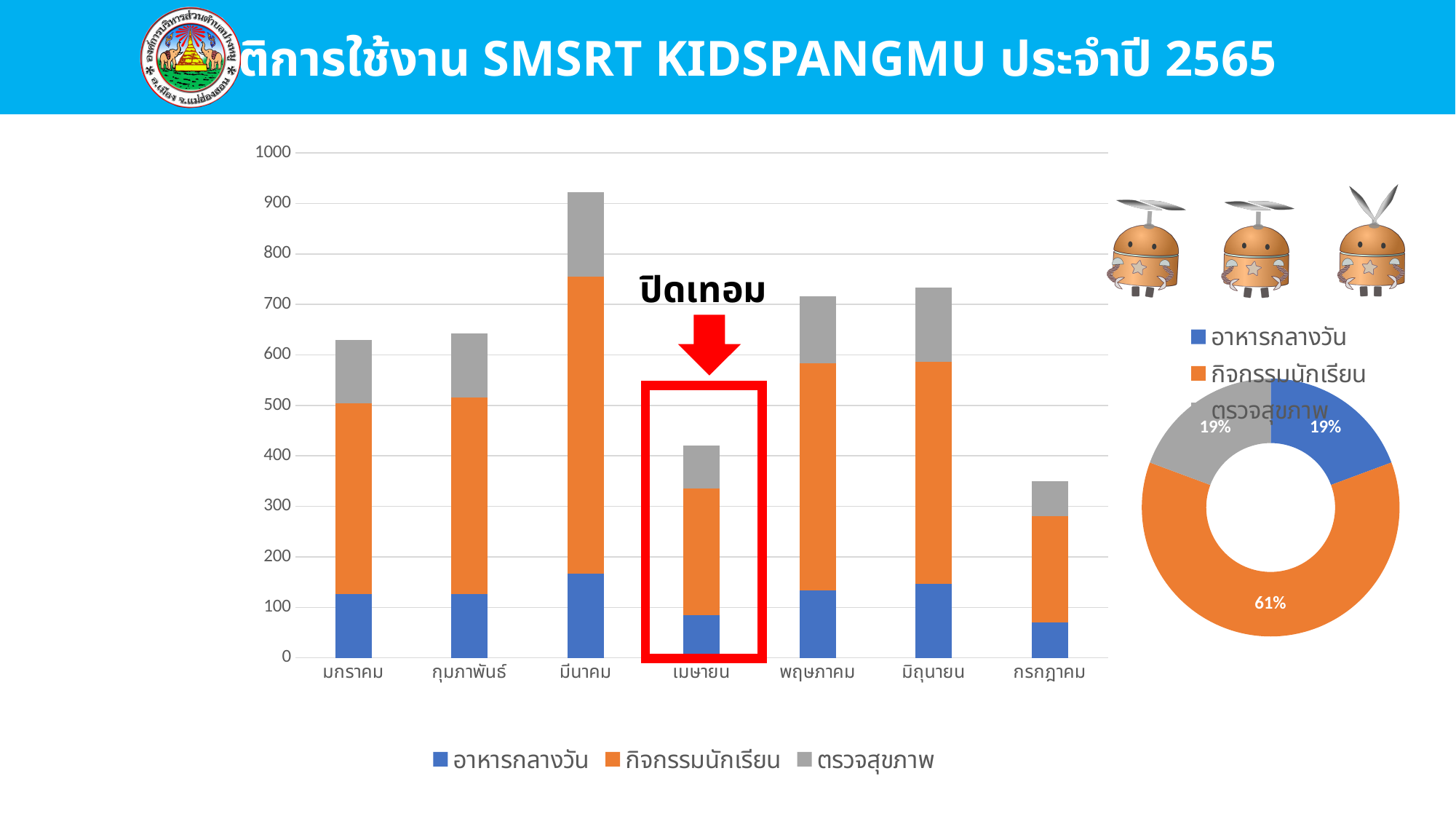
In the bar chart, is the total for มกราคม greater or less than 600? greater In the bar chart, how many months are shown on the x axis? 7 In the bar chart, which month has the larger total bar, มิถุนายน or กุมภาพันธ์? มิถุนายน In the bar chart, which month has the lowest total bar? กรกฎาคม In the donut chart on the right, what share does อาหารกลางวัน have? 19% In the bar chart, which month has the highest total bar? มีนาคม In the donut chart on the right, what share does กิจกรรมนักเรียน have? 61% In the bar chart, is the total for เมษายน greater or less than 500? less In the bar chart, which month is marked with the red box and the label ปิดเทอม? เมษายน In the bar chart, how many series does the legend list? 3 What kind of chart is the chart on the left of the slide? bar chart In the bar chart, is the total for มีนาคม greater or less than 800? greater